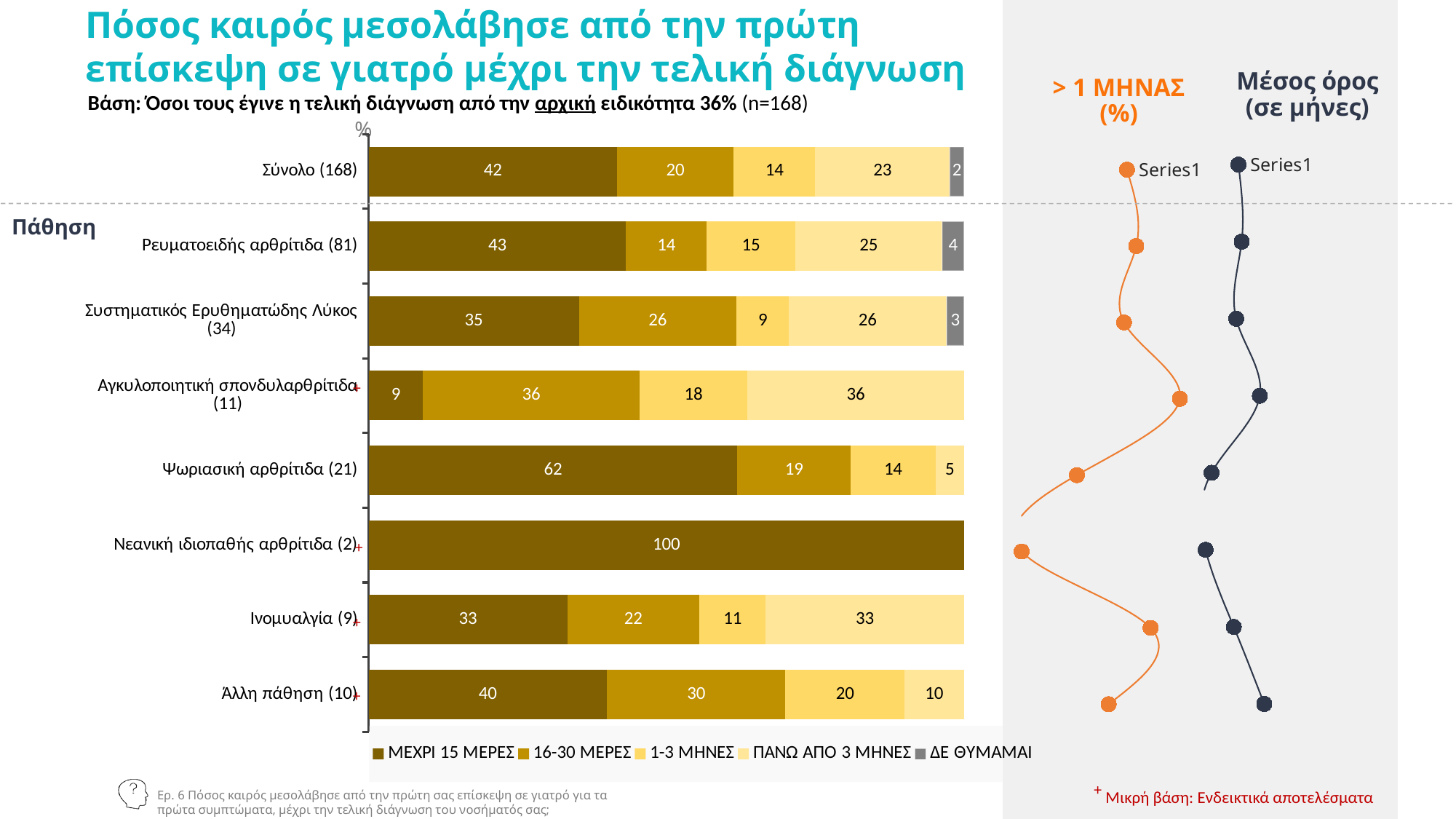
In the stacked bar chart, which category has the lowest value for ΜΕΧΡΙ 15 ΜΕΡΕΣ? Αγκυλοποιητική σπονδυλαρθρίτιδα (11) In the stacked bar chart, what is the value for ΠΑΝΩ ΑΠΟ 3 ΜΗΝΕΣ in the Ρευματοειδής αρθρίτιδα (81) bar? 25 How many categories (rows) does the stacked bar chart show? 8 In the stacked bar chart, which category has the highest value for ΜΕΧΡΙ 15 ΜΕΡΕΣ? Νεανική ιδιοπαθής αρθρίτιδα (2) In the stacked bar chart, which is larger: the ΔΕ ΘΥΜΑΜΑΙ value for Ρευματοειδής αρθρίτιδα (81) or for Σύνολο (168)? Ρευματοειδής αρθρίτιδα (81) In the stacked bar chart, which legend entry is shown in grey? ΔΕ ΘΥΜΑΜΑΙ What kind of chart is the main chart on the left of the slide? Stacked bar chart In the stacked bar chart, what is the difference between the ΜΕΧΡΙ 15 ΜΕΡΕΣ values for Ψωριασική αρθρίτιδα (21) and Ινομυαλγία (9)? 29 In the stacked bar chart, what is the total of the Άλλη πάθηση (10) bar? 100 How many series does the legend of the stacked bar chart list? 5 In the stacked bar chart, what is the value for ΜΕΧΡΙ 15 ΜΕΡΕΣ in the Σύνολο (168) bar? 42 In the stacked bar chart, what is the value for 16-30 ΜΕΡΕΣ in the Συστηματικός Ερυθηματώδης Λύκος (34) bar? 26